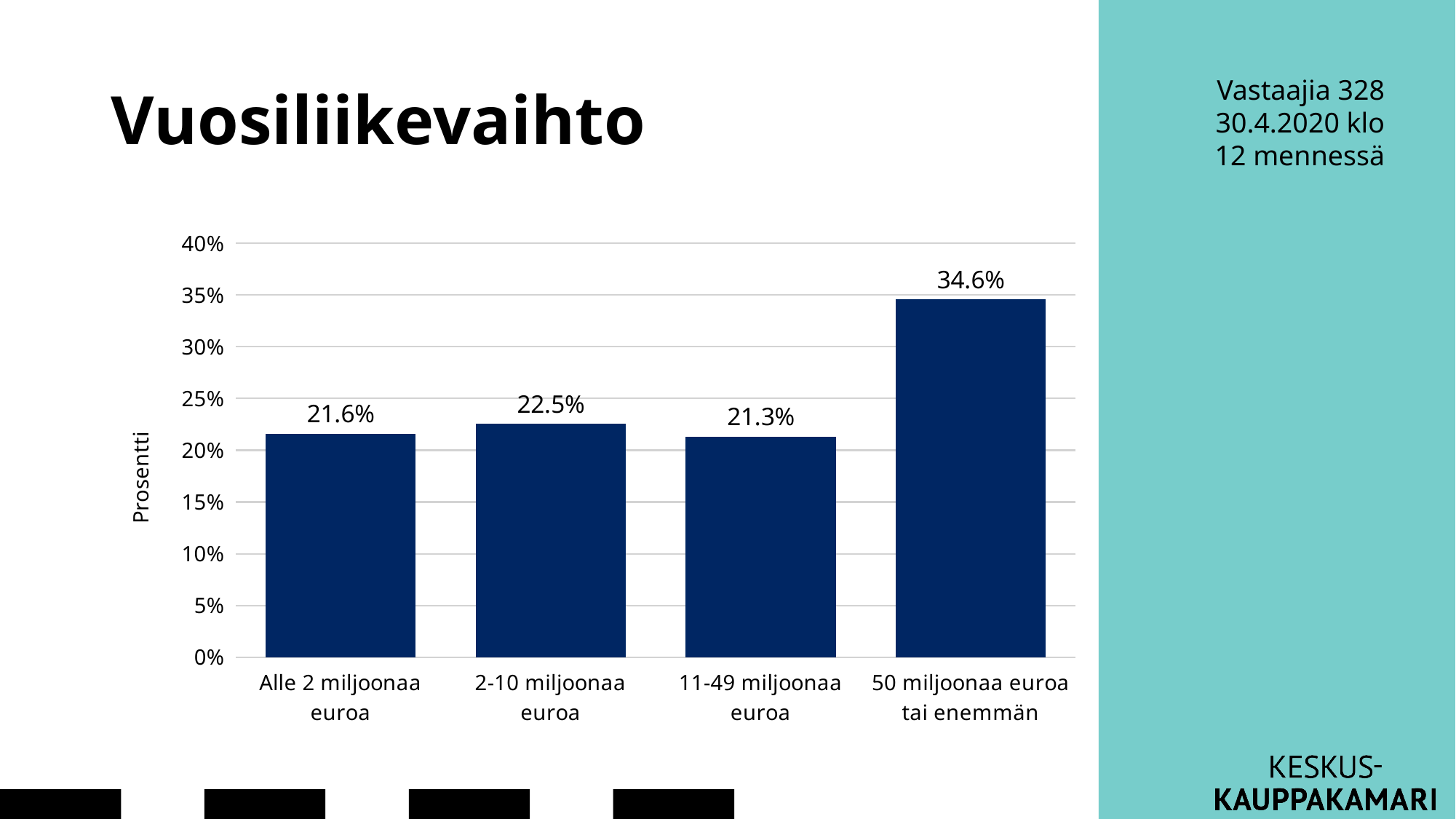
What is the difference between the values for "2-10 miljoonaa euroa" and "11-49 miljoonaa euroa"? 1.2% What is the value for "11-49 miljoonaa euroa"? 21.3% What is the value for "50 miljoonaa euroa tai enemmän"? 34.6% What is the difference between the values for "50 miljoonaa euroa tai enemmän" and "2-10 miljoonaa euroa"? 12.1% What kind of chart is shown on the slide? bar chart Which is larger, the value for "50 miljoonaa euroa tai enemmän" or the value for "Alle 2 miljoonaa euroa"? 50 miljoonaa euroa tai enemmän What is the value for "Alle 2 miljoonaa euroa"? 21.6% What is the value for "2-10 miljoonaa euroa"? 22.5% Which category has the highest value? 50 miljoonaa euroa tai enemmän What is the title of the chart on the slide? Vuosiliikevaihto Is the value for "50 miljoonaa euroa tai enemmän" greater or less than 30%? greater How many categories are shown on the x axis? 4